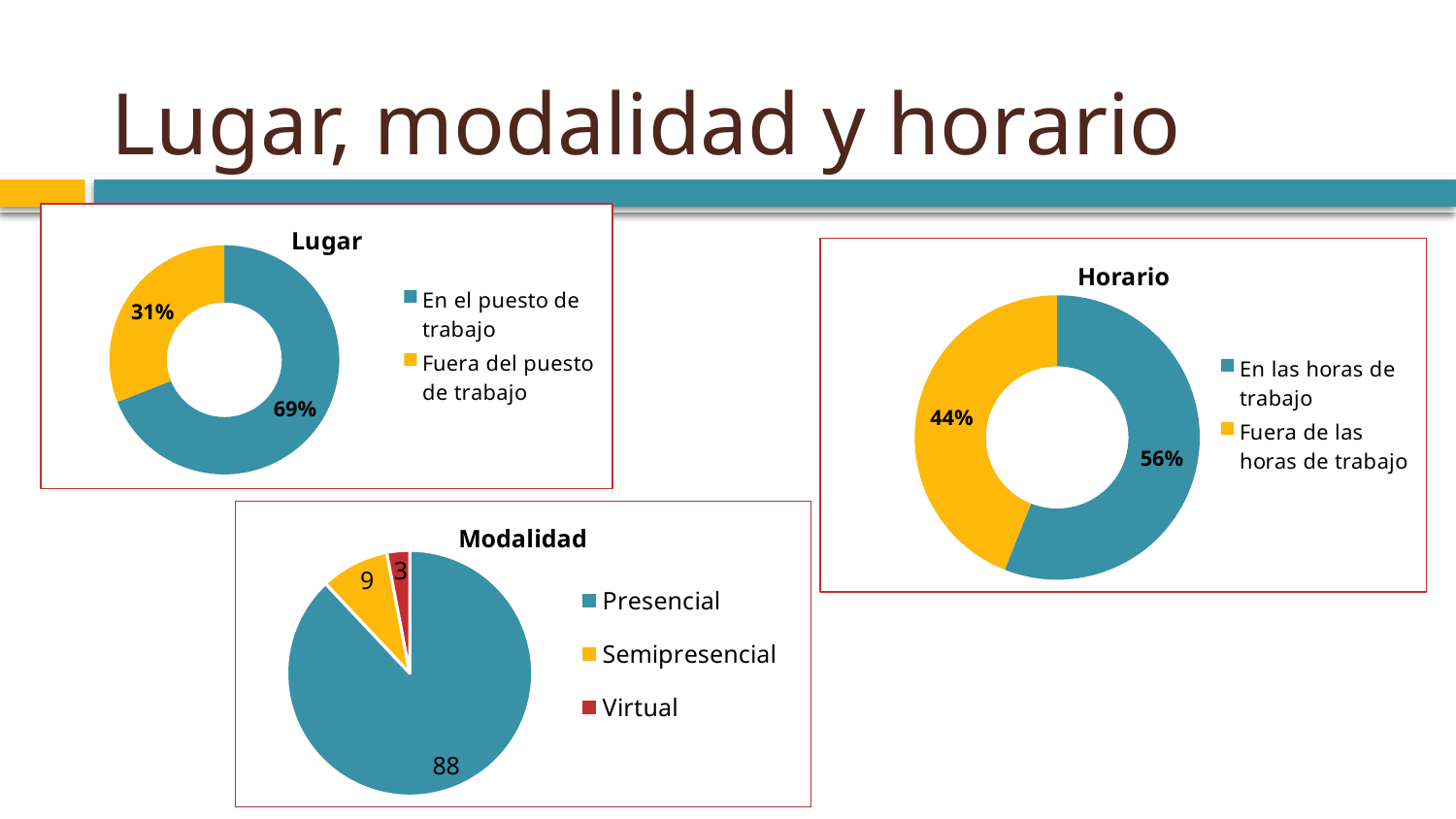
What kind of chart is the 'Modalidad' chart? Pie chart In the 'Lugar' chart, what percentage is shown for 'Fuera del puesto de trabajo'? 31% In the 'Horario' chart, which is larger: 'En las horas de trabajo' or 'Fuera de las horas de trabajo'? En las horas de trabajo In the 'Horario' chart, what percentage is shown for 'Fuera de las horas de trabajo'? 44% In the 'Modalidad' chart, which category has the smallest value? Virtual In the 'Modalidad' chart, what is the value for 'Semipresencial'? 9 In the 'Lugar' chart, which category has the larger share? En el puesto de trabajo In the 'Horario' chart, what percentage is shown for 'En las horas de trabajo'? 56% How many categories does the 'Modalidad' chart show? 3 In the 'Modalidad' chart, what is the difference between the values for 'Presencial' and 'Semipresencial'? 79 In the 'Modalidad' chart, what is the value for 'Presencial'? 88 In the 'Lugar' chart, what percentage is shown for 'En el puesto de trabajo'? 69%